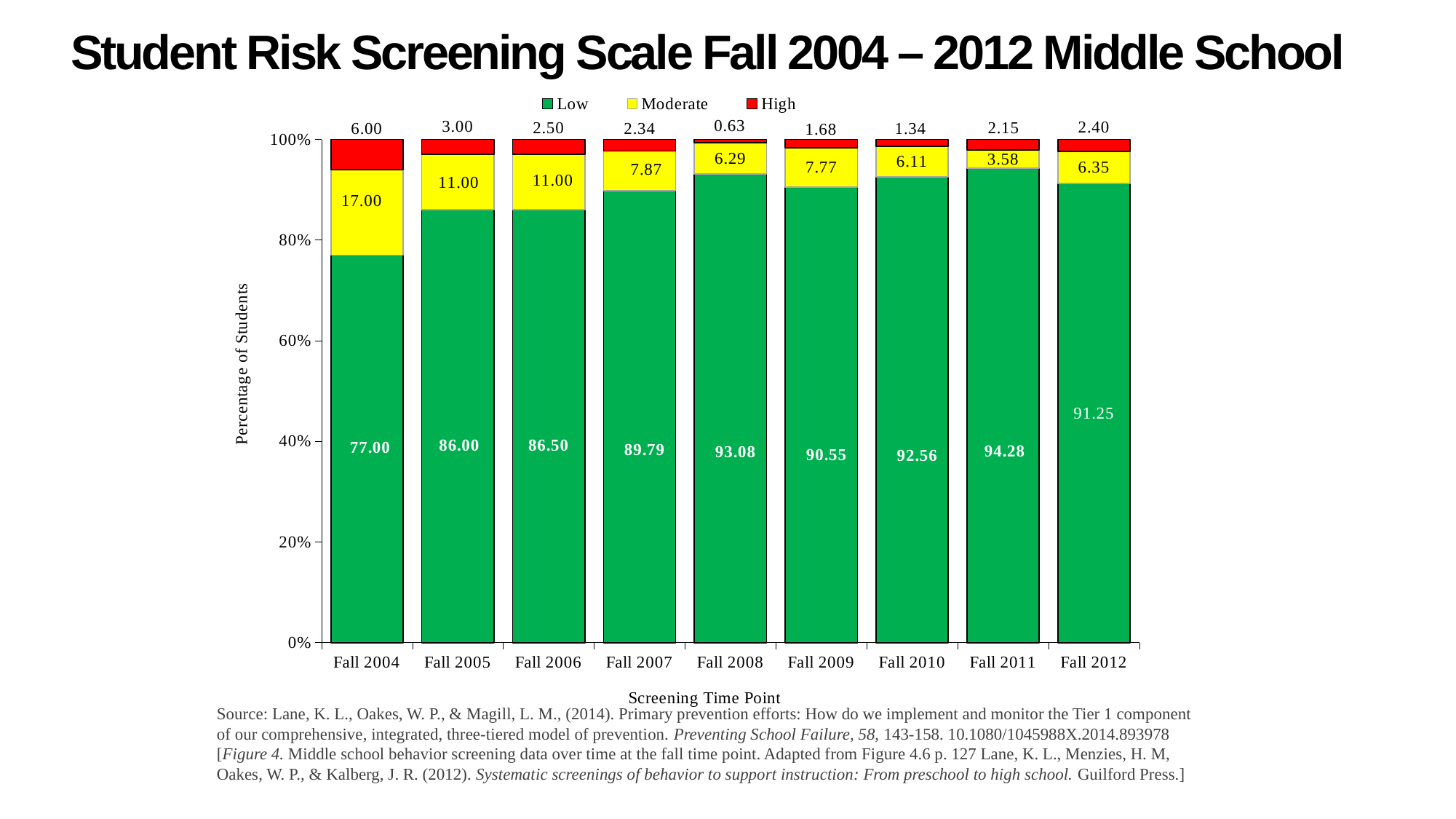
Which screening time point has the highest Low value? Fall 2011 Which screening time point has the lowest High value? Fall 2008 Which has the larger Moderate value, Fall 2009 or Fall 2010? Fall 2009 How many series does the legend list? 3 What is the Low value for Fall 2004? 77.00 Do the High values rise or fall from Fall 2004 to Fall 2008? Fall What is the Moderate value for Fall 2007? 7.87 What is the difference between the Low values for Fall 2005 and Fall 2004? 9.00 What is the High value for Fall 2008? 0.63 Which screening time point has the highest Moderate value? Fall 2004 How many screening time points are shown on the x axis? 9 What kind of chart is shown on the slide? Stacked bar chart